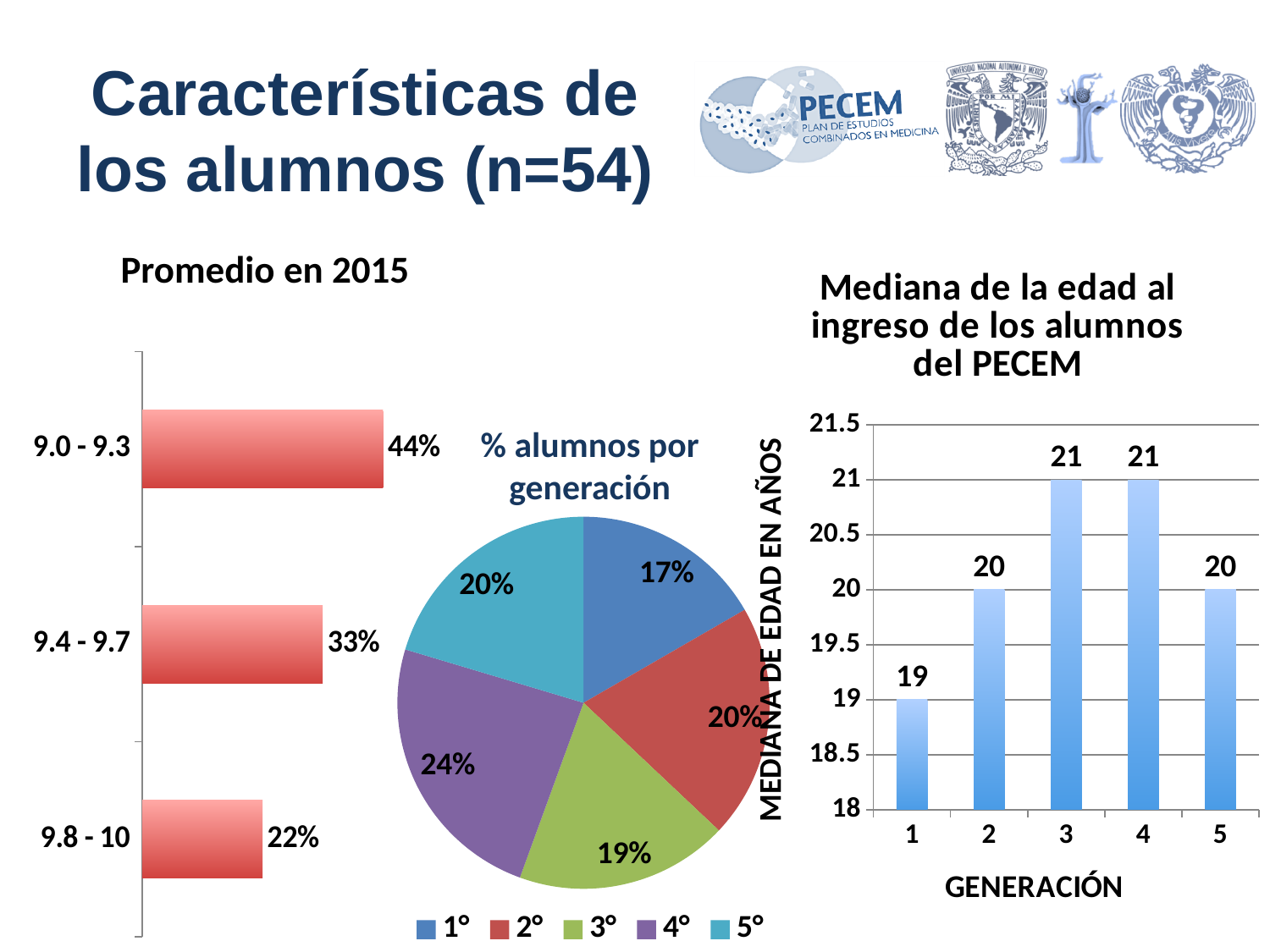
In the 'Mediana de la edad al ingreso de los alumnos del PECEM' chart, which generation has the lowest median age? 1 In the '% alumnos por generación' pie chart, what share of students belongs to 4°? 24% In the 'Mediana de la edad al ingreso de los alumnos del PECEM' chart, what is the median age for generation 1? 19 In the 'Promedio en 2015' chart, which average range has the lowest percentage? 9.8 - 10 In the 'Promedio en 2015' chart, what is the difference between the 9.0 - 9.3 and 9.4 - 9.7 percentages? 11% How many generations does the legend of the '% alumnos por generación' pie chart list? 5 In the 'Mediana de la edad al ingreso de los alumnos del PECEM' chart, what is the difference in median age between generation 3 and generation 1? 2 In the 'Promedio en 2015' chart, what percentage of students had an average of 9.0 - 9.3? 44% In the '% alumnos por generación' pie chart, which generation has the smallest share? 1° In the '% alumnos por generación' pie chart, which is larger, the share for 3° or the share for 4°? 4° How many generations are shown on the x axis of the 'Mediana de la edad al ingreso de los alumnos del PECEM' chart? 5 What type of chart is 'Promedio en 2015'? bar chart